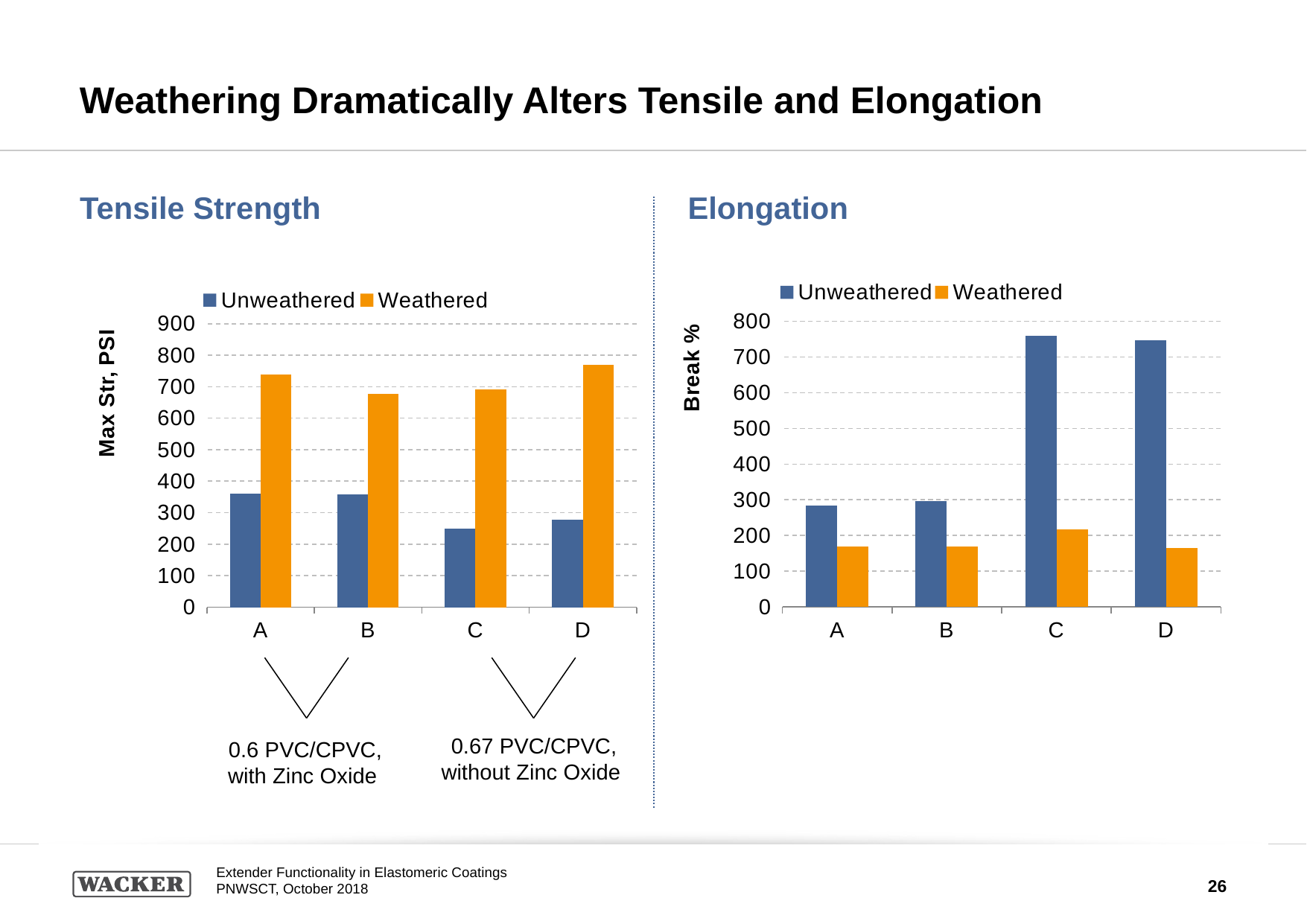
How many categories are shown on the x axis of the Elongation chart? 4 On the Tensile Strength chart, for category A, which is larger: the Unweathered or the Weathered value? Weathered What is the y-axis label of the Elongation chart? Break % On the Elongation chart, is the Weathered value for A greater or less than 200? less On the Elongation chart, for category D, which is larger: the Unweathered or the Weathered value? Unweathered On the Tensile Strength chart, which category has the lowest Unweathered value? C On the Tensile Strength chart, is the Weathered value for A greater or less than 700? greater On the Elongation chart, is the Unweathered value for C greater or less than 700? greater How many series does the legend of the Tensile Strength chart list? 2 On the Elongation chart, which category has the highest Weathered value? C What kind of chart is the Tensile Strength chart? bar chart